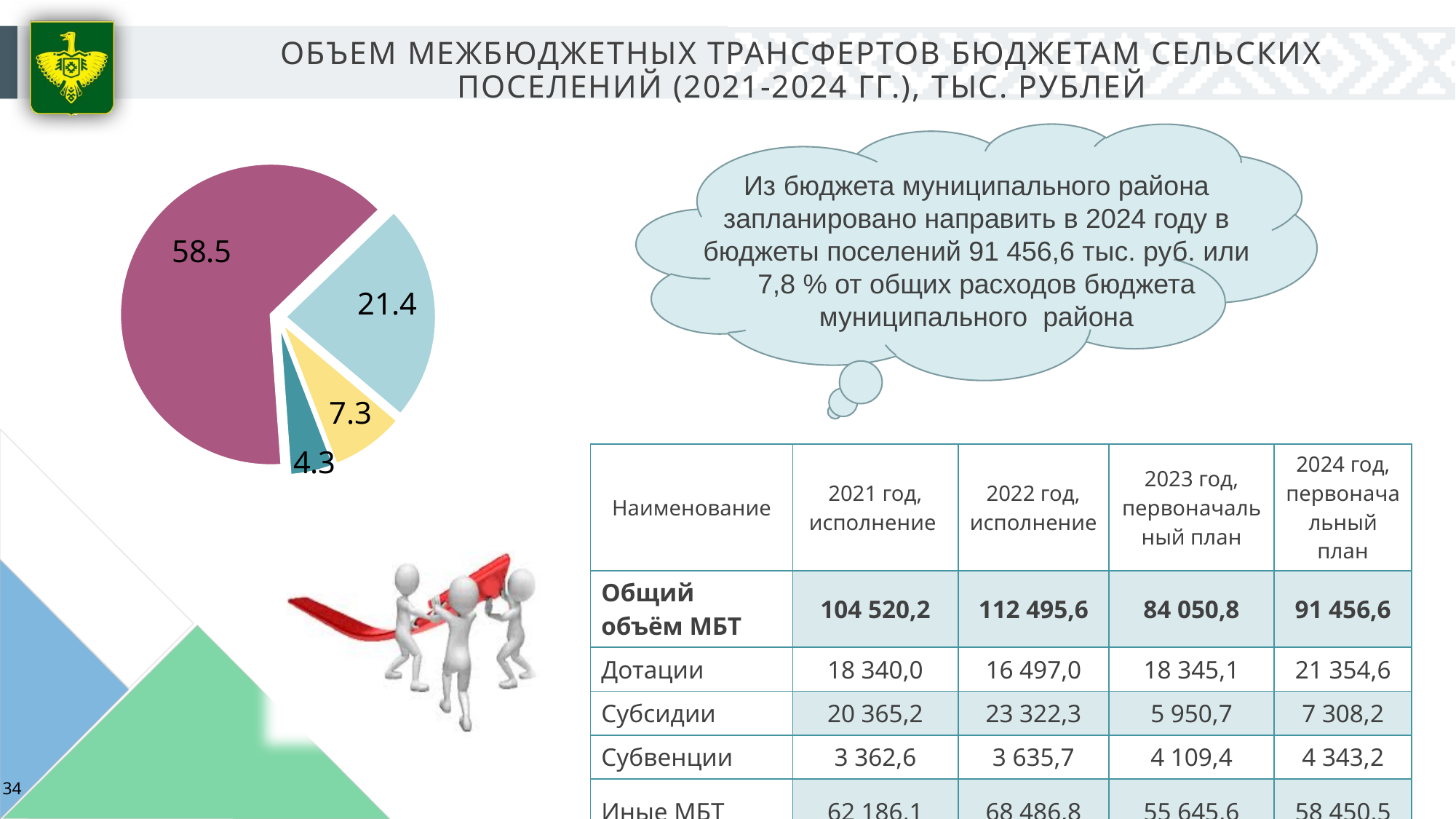
What value is labelled on the light blue slice of the pie chart? 21.4 What is the value of the smallest slice in the pie chart? 4.3 What value is labelled on the dark teal slice of the pie chart? 4.3 Does the pie chart have a legend? No What is the difference between the largest and smallest slice values in the pie chart? 54.2 What kind of chart is shown on the left of the slide? pie chart What colour is the largest slice of the pie chart? magenta (purple-red) How many slices does the pie chart have? 4 What is the difference between the slice labelled 21.4 and the slice labelled 7.3 in the pie chart? 14.1 What is the value of the largest slice in the pie chart? 58.5 Which slice is larger in the pie chart, the yellow one or the dark teal one? the yellow one What value is labelled on the yellow slice of the pie chart? 7.3